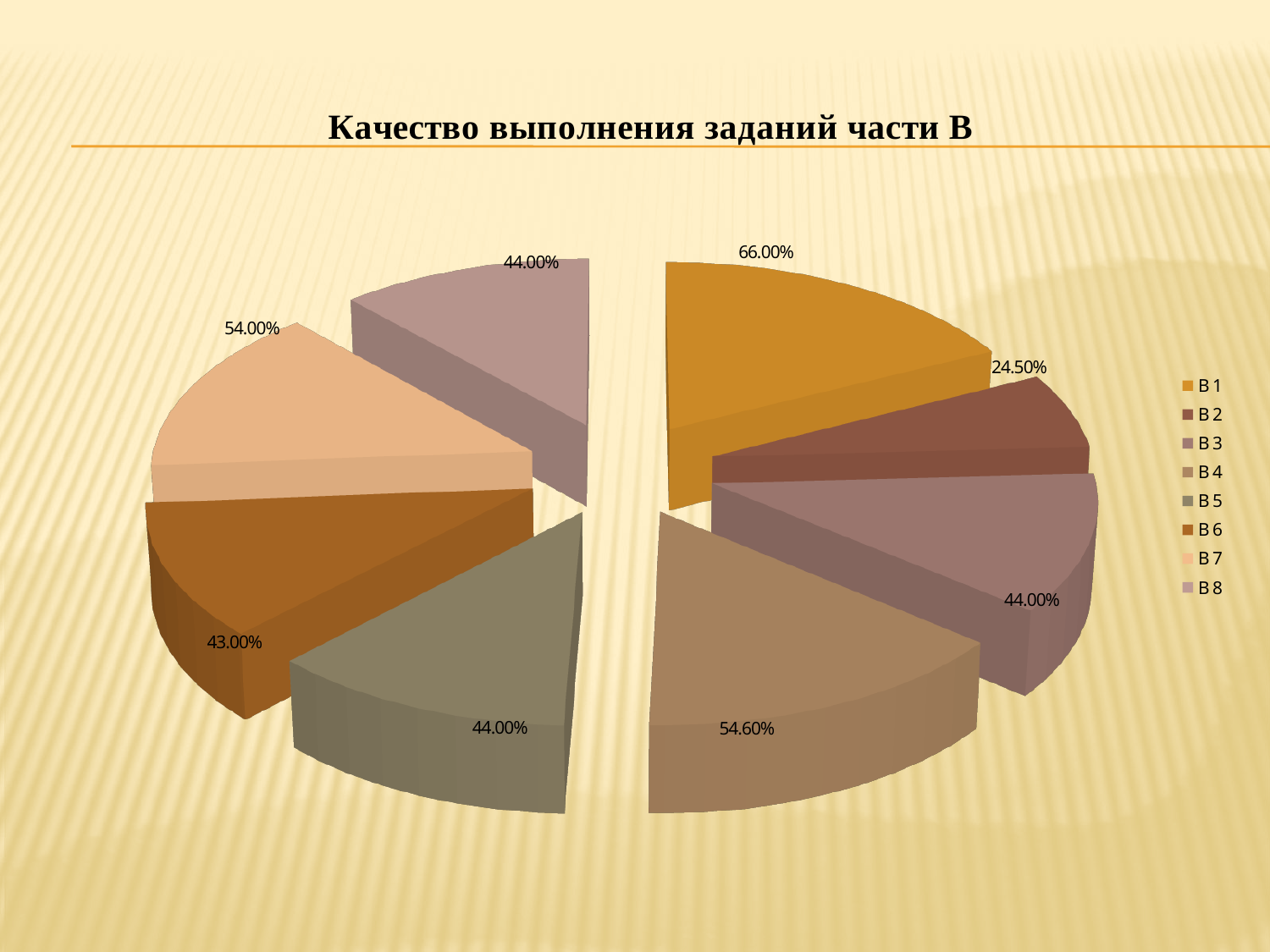
Which category has the highest value? В 1 What value is shown for В 1? 66.00% What is the title of the chart? Качество выполнения заданий части В What value is shown for В 6? 43.00% Which is larger, the value for В 4 or the value for В 7? В 4 Which category has the lowest value? В 2 What value is shown for В 4? 54.60% What value is shown for В 7? 54.00% What is the difference between the values for В 1 and В 2? 41.50% What value is shown for В 2? 24.50% How many slices does the pie chart have? 8 What type of chart is shown on the slide? Pie chart